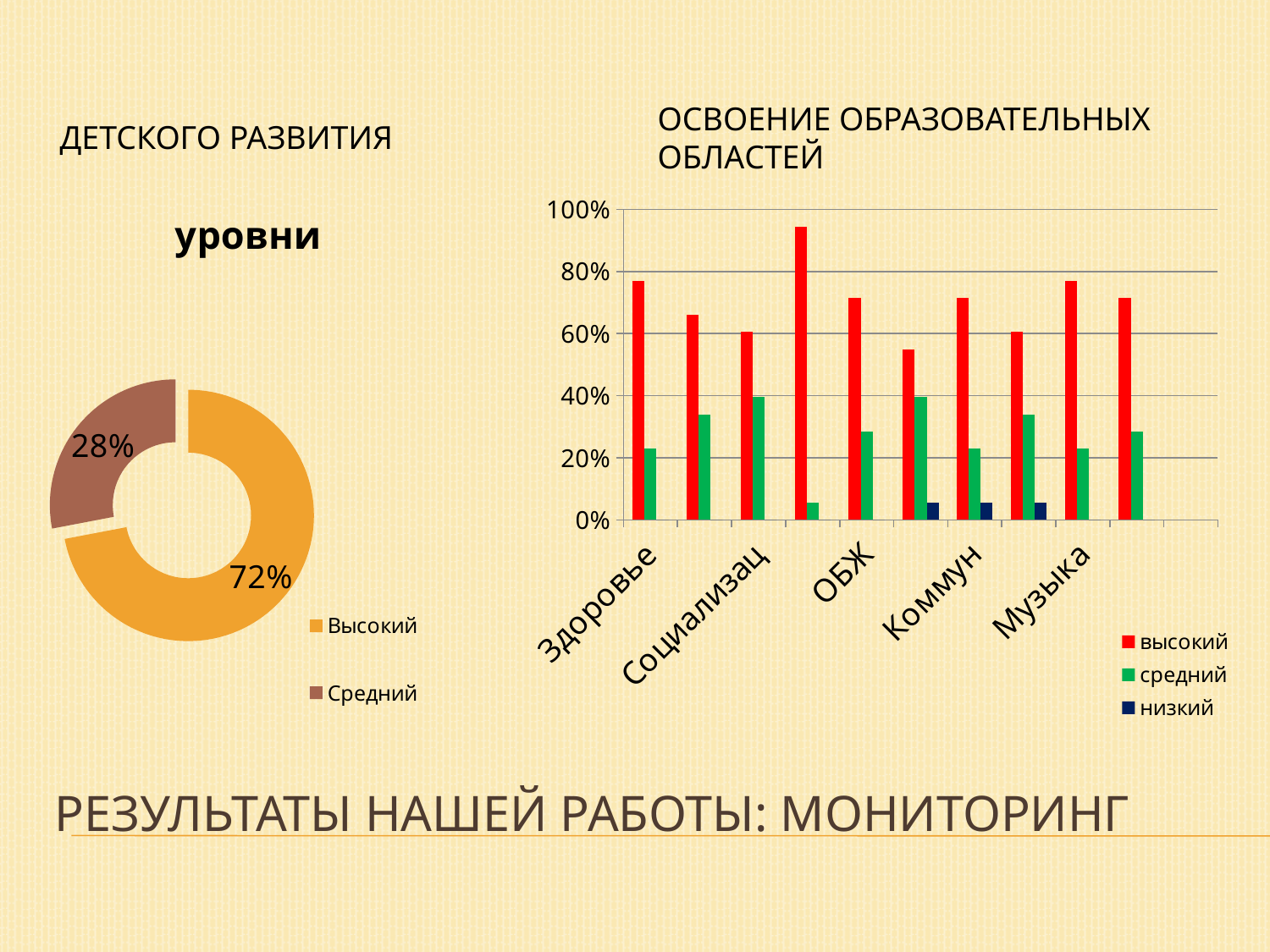
In the chart titled "ОСВОЕНИЕ ОБРАЗОВАТЕЛЬНЫХ ОБЛАСТЕЙ", which series is larger for Музыка, высокий or средний? высокий In the doughnut chart titled "уровни", what is the value for Высокий? 72% How many categories does the legend of the doughnut chart titled "уровни" list? 2 In the doughnut chart titled "уровни", by how many percentage points does Высокий exceed Средний? 44% What kind of chart is the chart titled "уровни"? doughnut chart In the chart titled "ОСВОЕНИЕ ОБРАЗОВАТЕЛЬНЫХ ОБЛАСТЕЙ", what colour are the bars for the series низкий? dark blue What kind of chart is the chart titled "ОСВОЕНИЕ ОБРАЗОВАТЕЛЬНЫХ ОБЛАСТЕЙ"? bar chart In the doughnut chart titled "уровни", which category has the larger share? Высокий In the chart titled "ОСВОЕНИЕ ОБРАЗОВАТЕЛЬНЫХ ОБЛАСТЕЙ", is the средний value for Социализац greater or less than 20%? greater In the chart titled "ОСВОЕНИЕ ОБРАЗОВАТЕЛЬНЫХ ОБЛАСТЕЙ", is the высокий value for Здоровье greater or less than 60%? greater How many series does the legend of the chart titled "ОСВОЕНИЕ ОБРАЗОВАТЕЛЬНЫХ ОБЛАСТЕЙ" list? 3 In the doughnut chart titled "уровни", what is the value for Средний? 28%